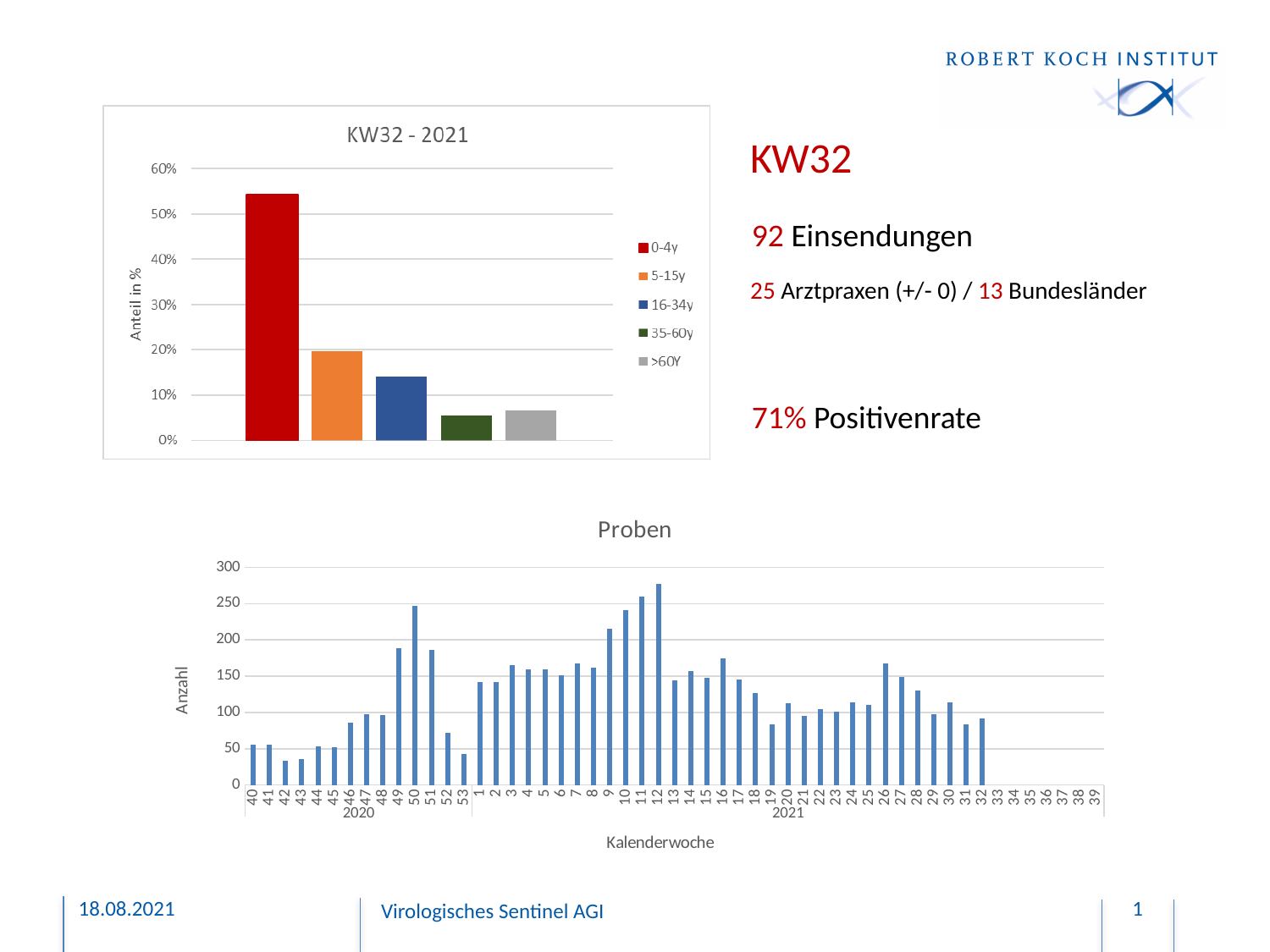
What kind of chart is the chart titled 'Proben'? bar chart In the chart titled 'Proben', is the value for week 32 of 2021 greater or less than 100? less In the chart titled 'KW32 - 2021', is the value for 5-15y greater or less than 30%? less In the chart titled 'KW32 - 2021', is the value for 35-60y greater or less than 10%? less In the chart titled 'KW32 - 2021', which age group has the highest share? 0-4y What is the y-axis title of the chart titled 'KW32 - 2021'? Anteil in % In the chart titled 'Proben', do the values rise or fall from week 9 to week 12 of 2021? rise How many entries does the legend of the chart titled 'KW32 - 2021' list? 5 In the chart titled 'KW32 - 2021', which is larger, the value for 5-15y or the value for 16-34y? 5-15y In the chart titled 'Proben', which calendar week has the highest value? 12 (2021)